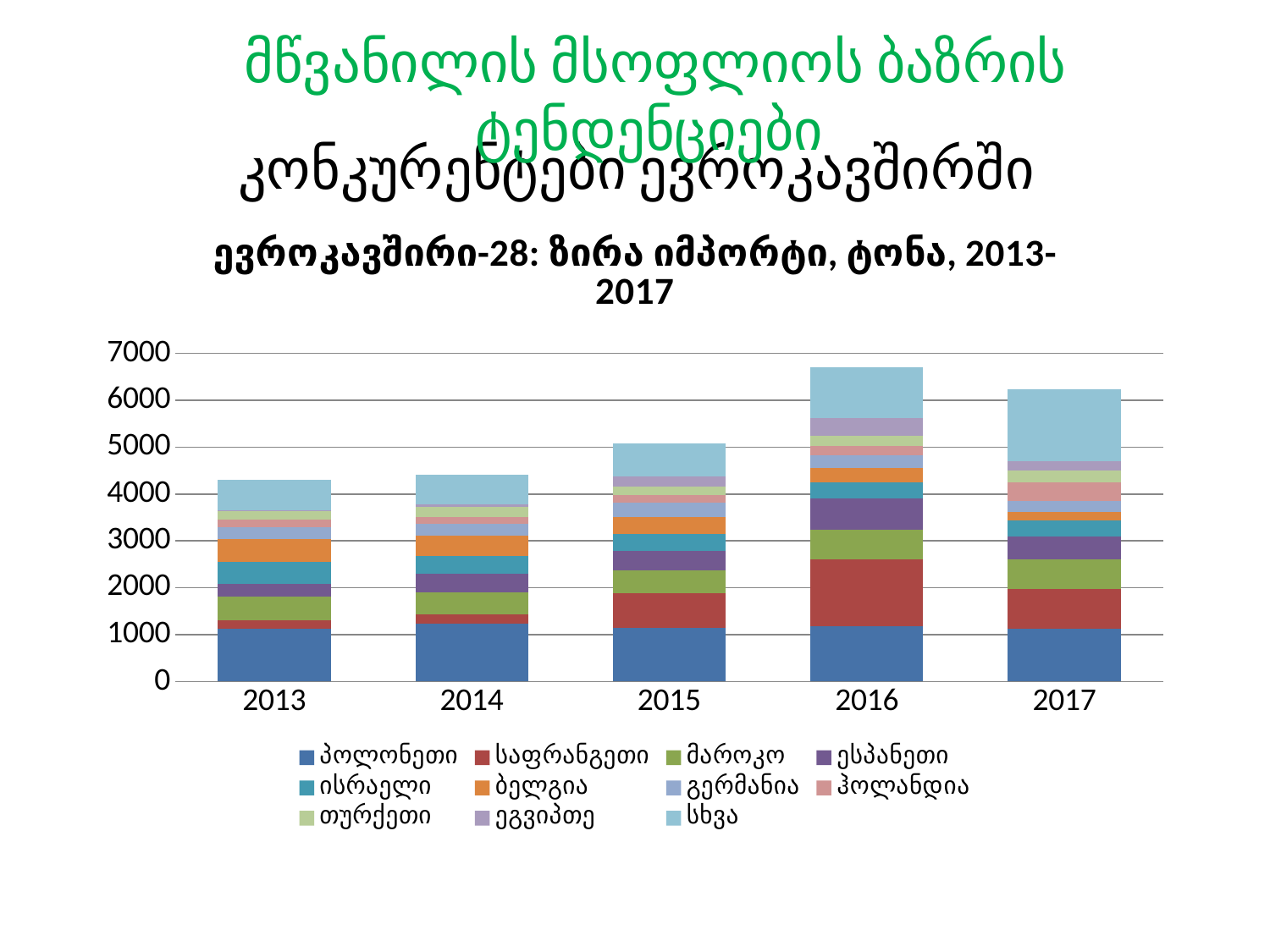
Which total is larger, 2013 or 2015? 2015 Is the total for 2014 greater or less than 5000? less Which total is larger, 2016 or 2017? 2016 What kind of chart is shown on the slide? stacked bar chart How many years (categories) are shown on the x axis? 5 What is the title of the chart? ევროკავშირი-28: ზირა იმპორტი, ტონა, 2013-2017 How many series does the legend list? 11 Which year has the highest total bar? 2016 Do the total bars rise or fall from 2013 to 2016? rise Is the total for 2013 greater or less than 5000? less Is the total for 2017 greater or less than 5000? greater